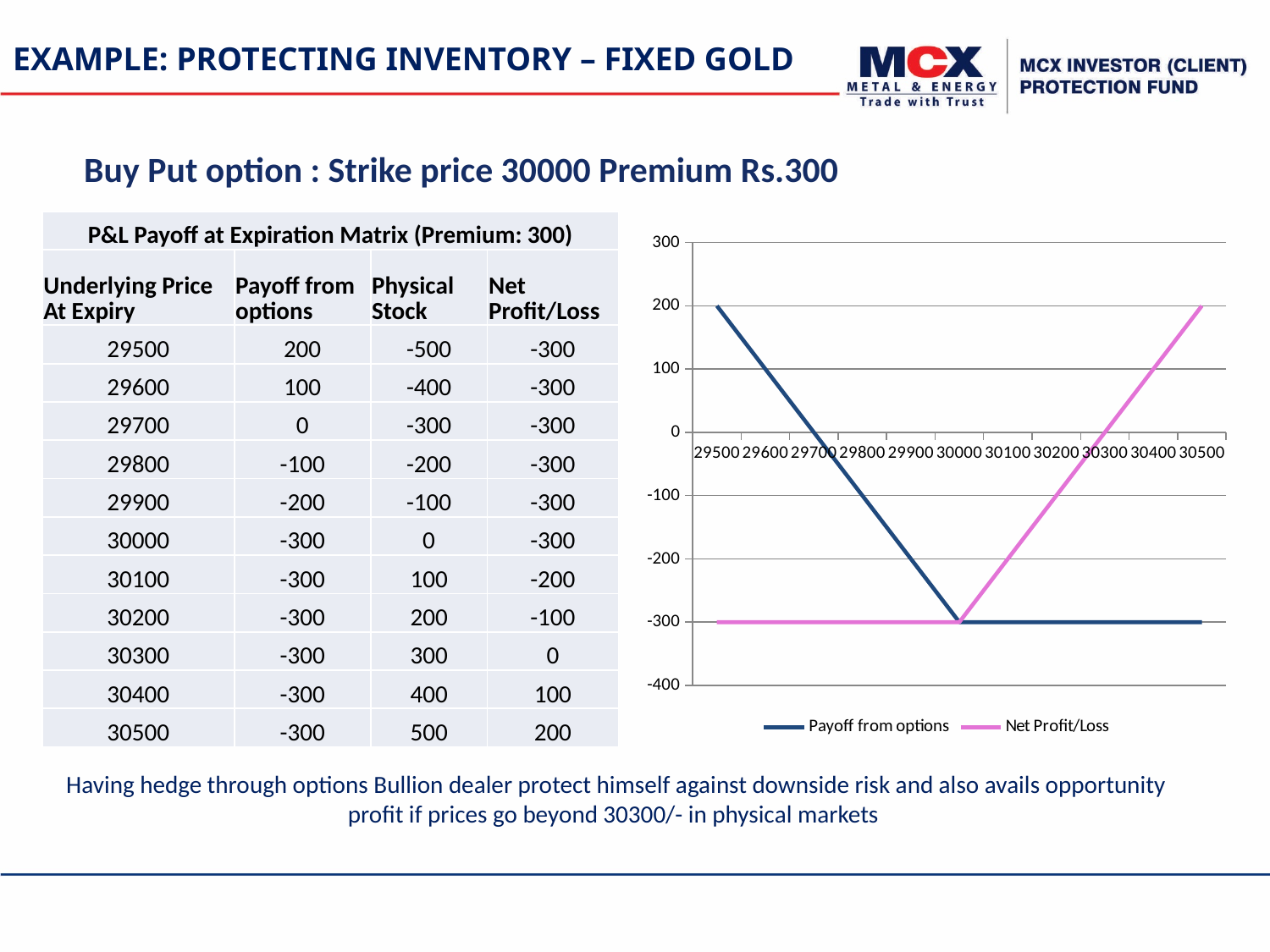
What kind of chart is shown on the slide? Line chart How many underlying price points are plotted along the x axis of the chart? 11 How many series does the chart legend list? 2 What is the value of Payoff from options at an underlying price of 29500? 200 At an underlying price of 29500, which series has the higher value: Payoff from options or Net Profit/Loss? Payoff from options At an underlying price of 30500, what is the difference between Net Profit/Loss and Payoff from options? 500 What is the lowest value reached by the Net Profit/Loss line? -300 What is the Net Profit/Loss value at an underlying price of 30500? 200 Is the Net Profit/Loss value at 30400 greater or less than 0? greater What is the Net Profit/Loss value at an underlying price of 30300? 0 Which colour is used for the Net Profit/Loss line in the chart? Pink At which underlying price is Payoff from options highest? 29500